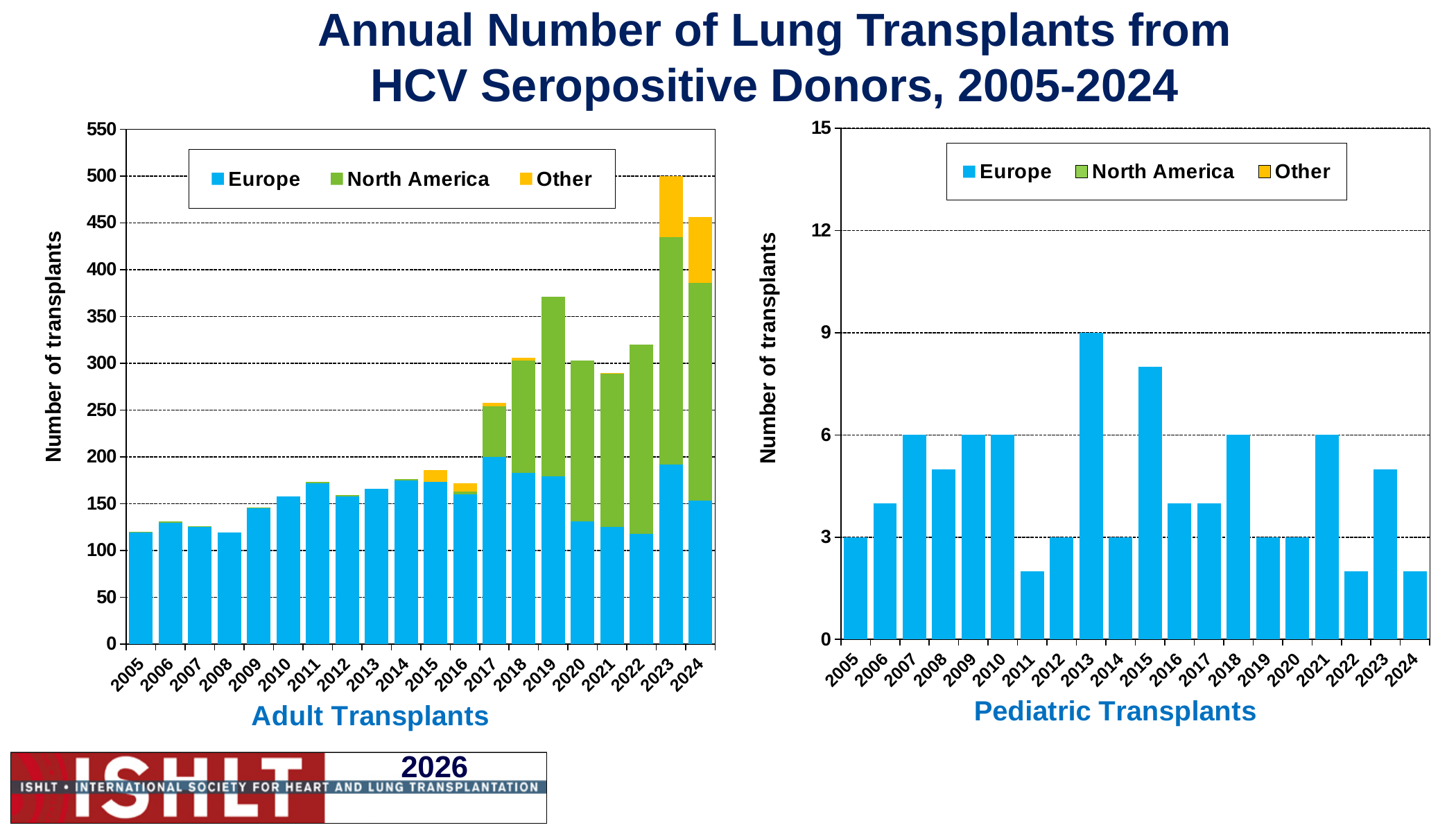
How many years are shown on the x axis of the Pediatric Transplants chart? 20 What kind of chart is the Adult Transplants chart? bar chart In the Pediatric Transplants chart, what is the number of transplants in 2005? 3 In the Pediatric Transplants chart, which year has the highest number of transplants? 2013 In the Pediatric Transplants chart, what is the number of transplants in 2021? 6 In the Adult Transplants chart, is the total number of transplants in 2005 greater or less than 150? less What is the label below the x axis of the left chart? Adult Transplants In the Pediatric Transplants chart, which year has more transplants, 2015 or 2016? 2015 In the Pediatric Transplants chart, what is the number of transplants in 2013? 9 In the Adult Transplants chart, is the total number of transplants in 2023 greater or less than 450? greater How many series does the legend of the Adult Transplants chart list? 3 In the Adult Transplants chart, which year has the larger total number of transplants, 2018 or 2019? 2019